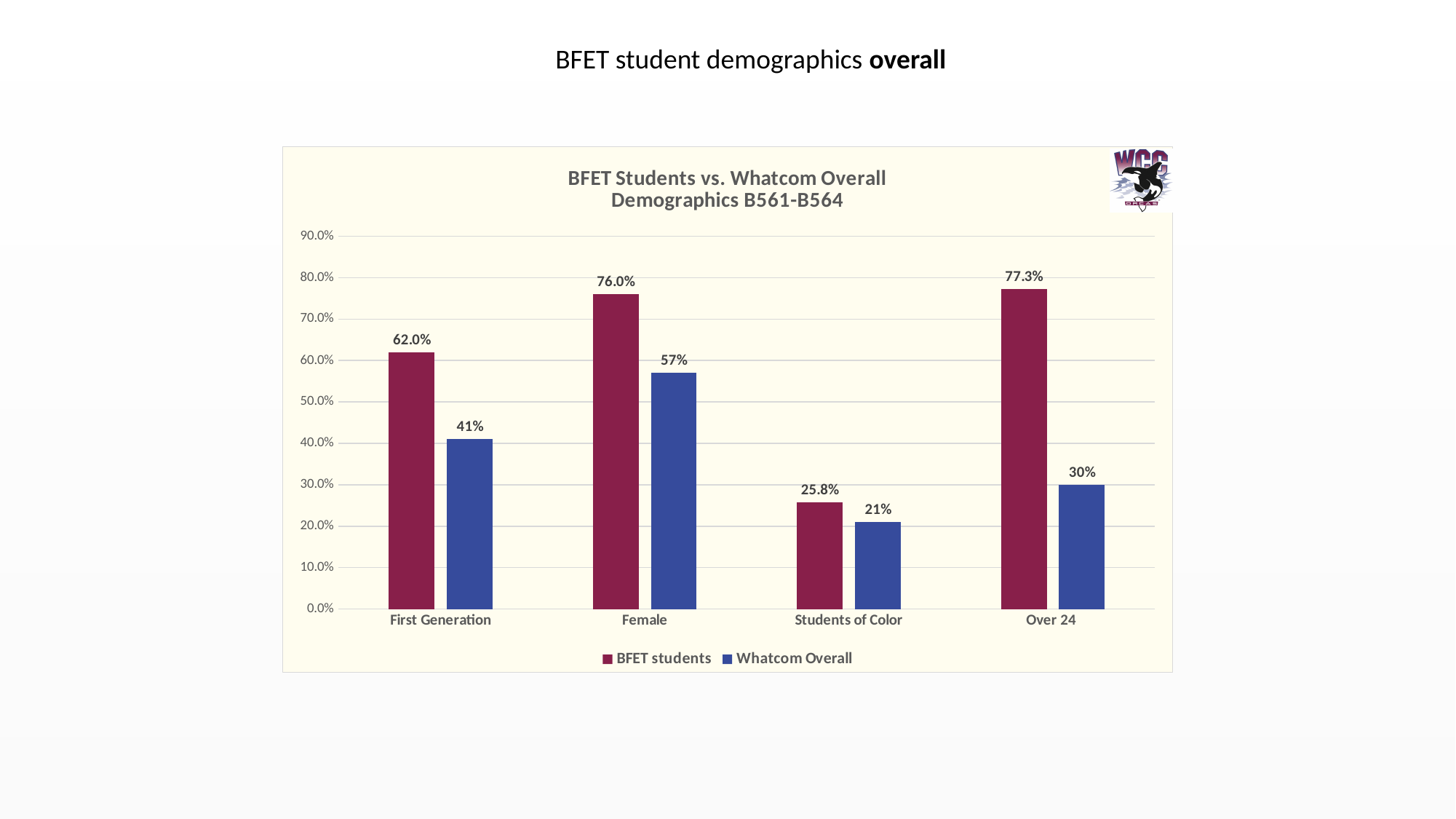
Which is larger in the Female category: BFET students or Whatcom Overall? BFET students What is the title of the chart? BFET Students vs. Whatcom Overall Demographics B561-B564 What is the value for Whatcom Overall in the Over 24 category? 30% Which category has the lowest value for Whatcom Overall? Students of Color What is the value for BFET students in the First Generation category? 62.0% What is the value for Whatcom Overall in the Female category? 57% What is the difference between the BFET students value and the Whatcom Overall value in the Over 24 category? 47.3% How many categories are shown on the x axis? 4 How many series does the legend list? 2 What is the value for BFET students in the Students of Color category? 25.8% Which category has the highest value for BFET students? Over 24 What kind of chart is shown on the slide? Bar chart